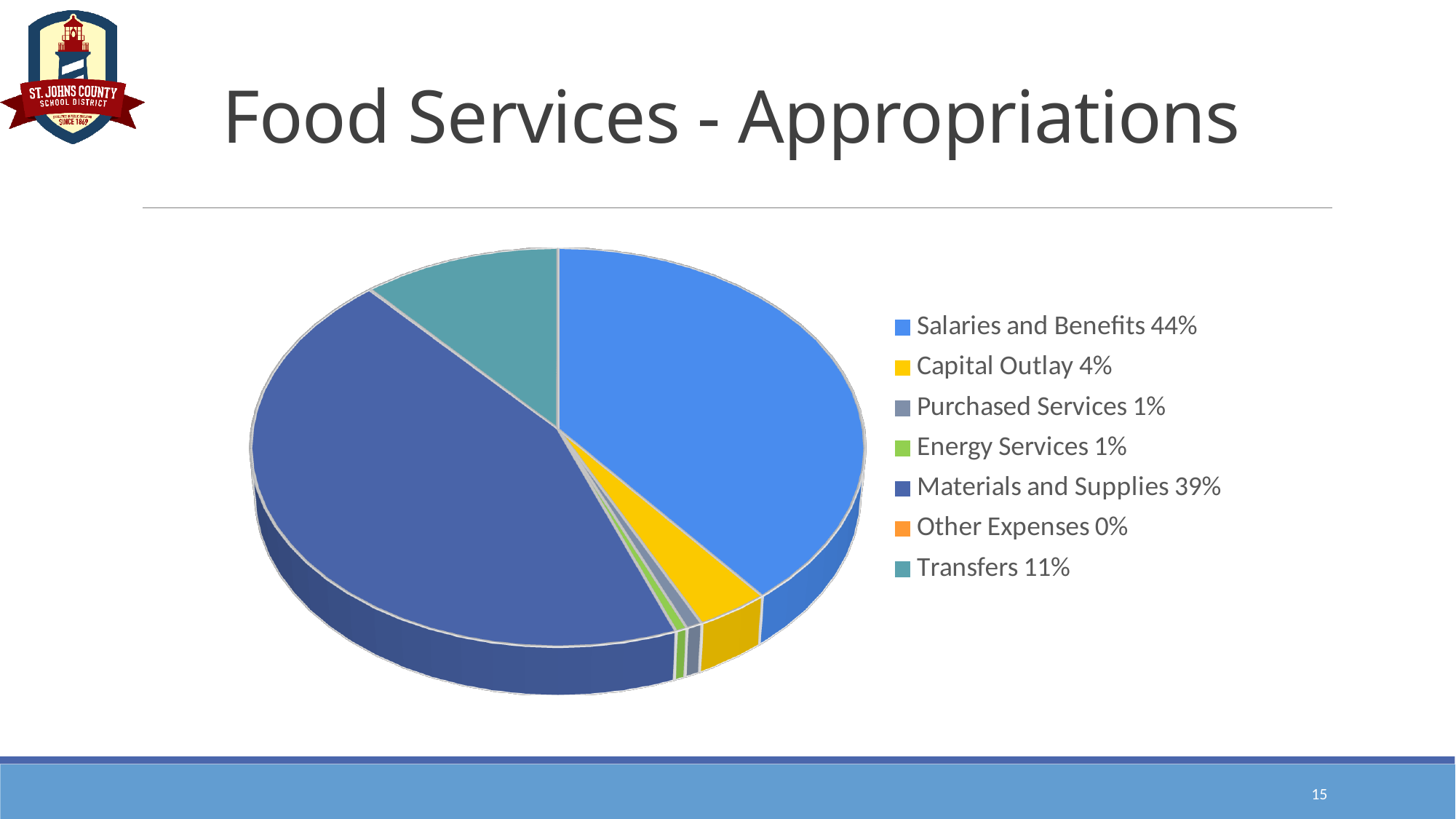
What type of chart is shown on the slide? Pie chart What is the title of the chart slide? Food Services - Appropriations What percentage of appropriations is Materials and Supplies? 39% What share of Food Services appropriations goes to Salaries and Benefits? 44% What is the difference in percentage points between Salaries and Benefits and Materials and Supplies? 5 Which category has the smallest share of appropriations? Other Expenses What percentage is shown for Other Expenses? 0% Which category has the largest share of appropriations? Salaries and Benefits What percentage of appropriations is Capital Outlay? 4% How many categories does the legend list? 7 What percentage of appropriations is Transfers? 11% Which is larger, Transfers or Capital Outlay? Transfers